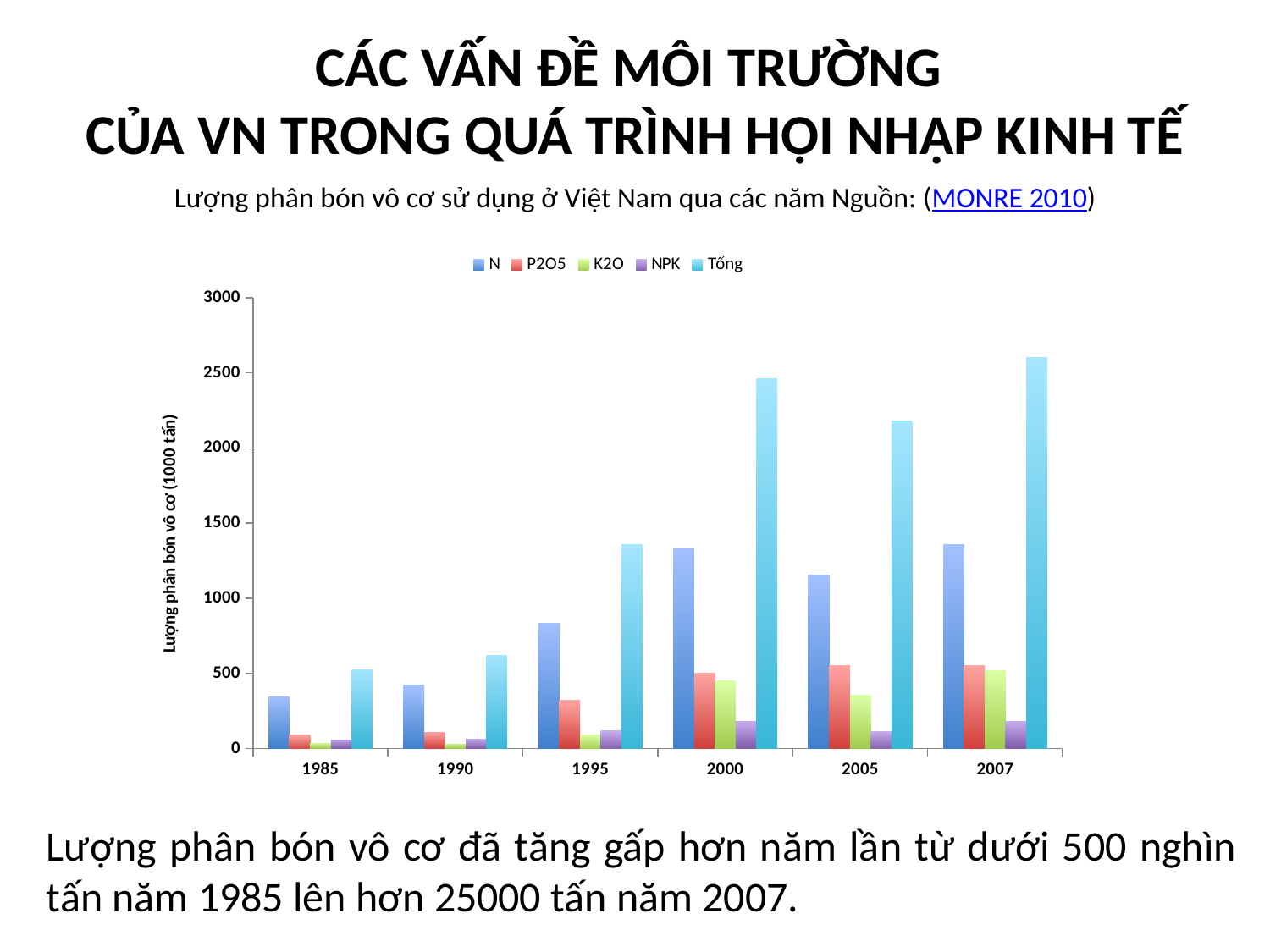
What is the title of the vertical axis? Lượng phân bón vô cơ (1000 tấn) Is the Tổng value for 2000 greater or less than 2000? greater How many series does the legend list? 5 Is the N value for 1995 greater or less than 1000? less What source is cited for the chart data? MONRE 2010 In which year is the Tổng value highest? 2007 What kind of chart is shown on the slide? bar chart In which year is the Tổng value lowest? 1985 How many years are shown on the x axis? 6 Does the N value rise or fall from 1985 to 2000? rise Is the Tổng value for 1985 greater or less than 1000? less Which is larger, the Tổng value for 2000 or for 2005? 2000